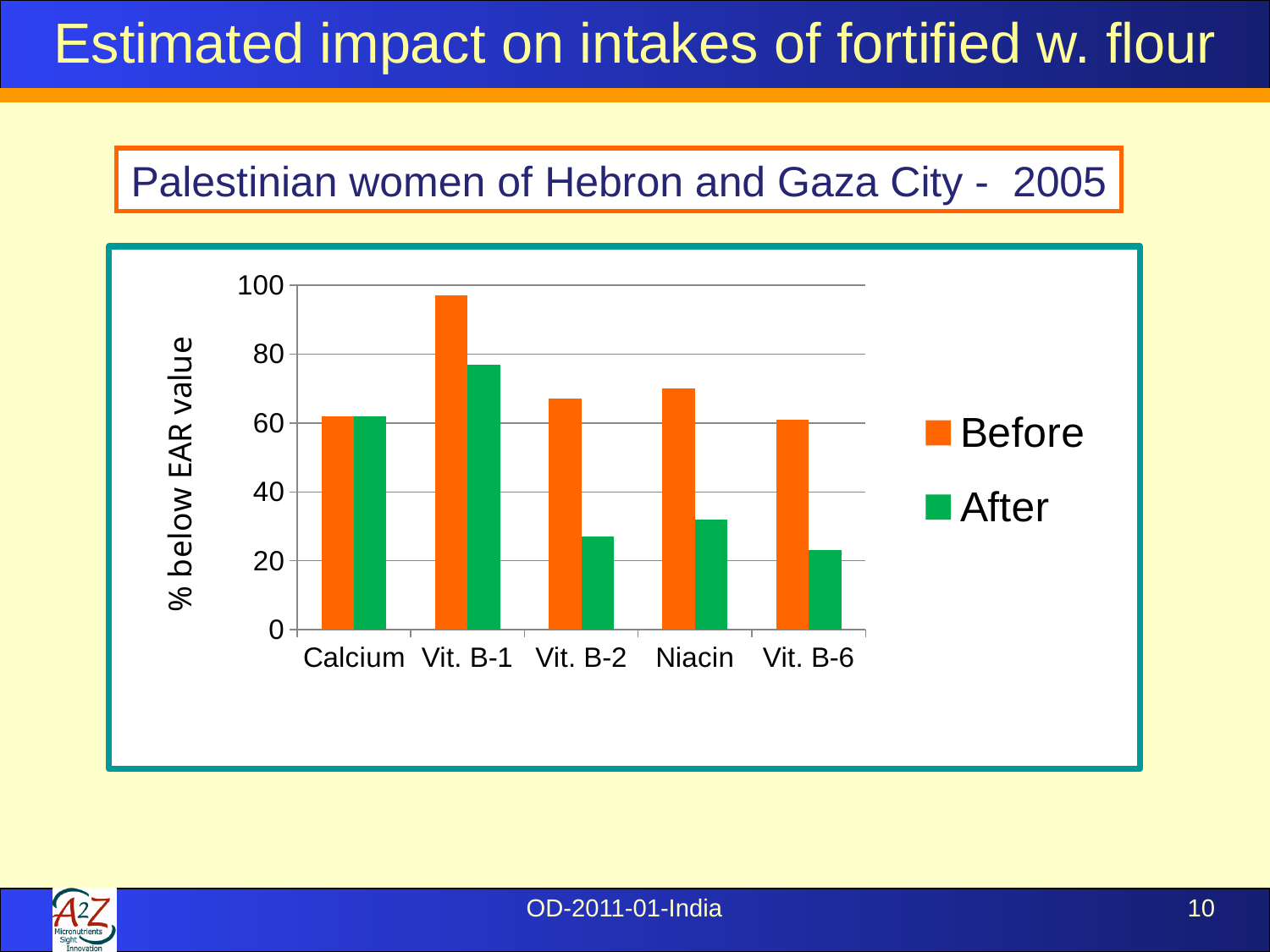
How many nutrient categories are shown on the x axis? 5 Is the After value for Vit. B-6 greater or less than 40? less Which is larger, the Before value for Niacin or the Before value for Vit. B-6? Niacin Which nutrient has the highest After value? Vit. B-1 What is the label on the vertical axis of the chart? % below EAR value What kind of chart is shown on the slide? bar chart Is the Before value for Vit. B-1 greater or less than 80? greater Is the Before value for Calcium greater or less than 40? greater Which nutrient has the highest Before value? Vit. B-1 Which is larger, the After value for Vit. B-1 or the After value for Niacin? Vit. B-1 How many series does the legend list? 2